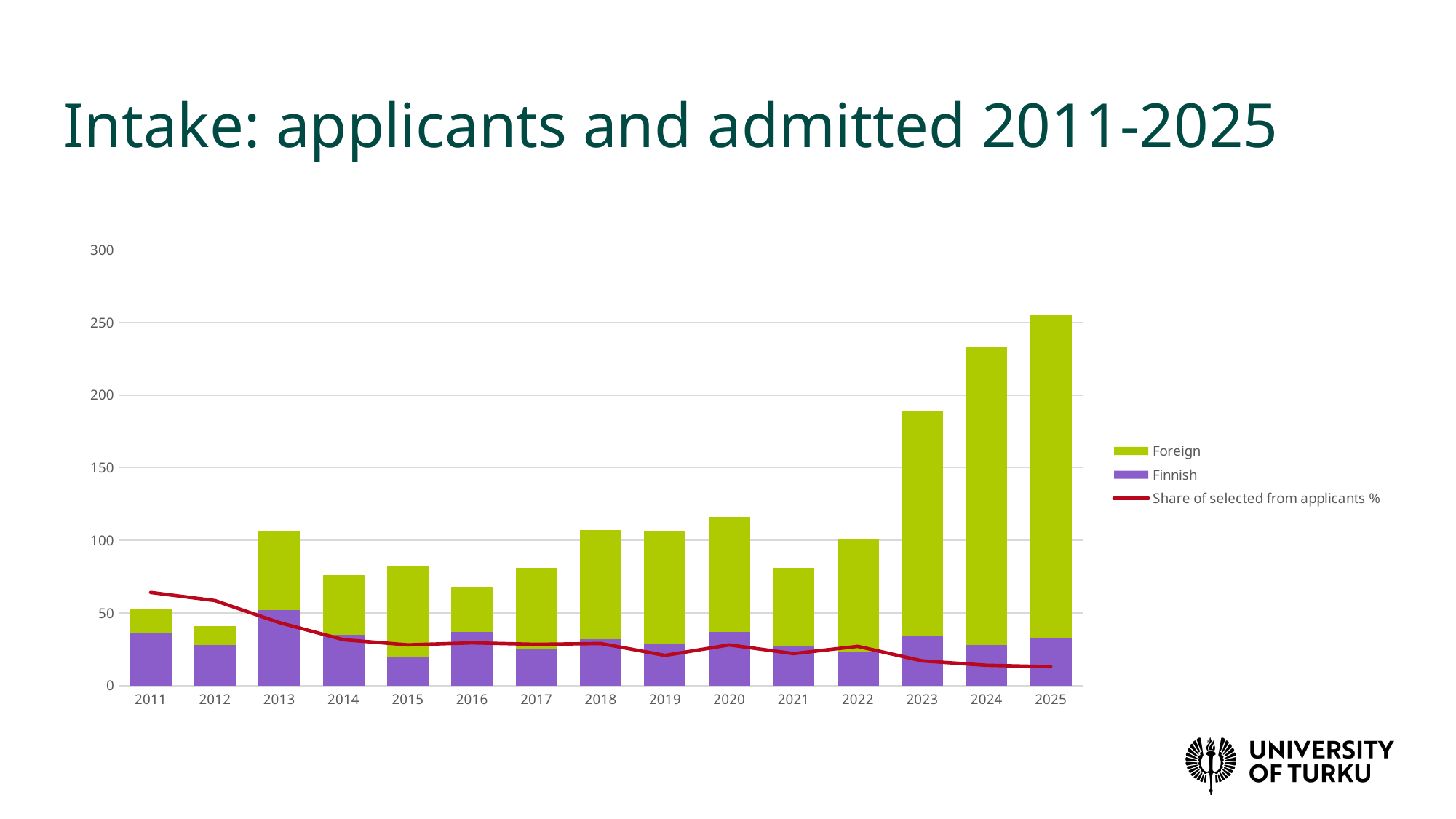
How many years are shown on the x axis? 15 How many series does the legend list? 3 Which series is shown in purple? Finnish Which year has the larger total bar, 2023 or 2024? 2024 Is the total bar height for 2016 greater or less than 100? less Which year has the tallest stacked bar? 2025 Does the 'Share of selected from applicants %' line generally rise or fall from 2011 to 2025? fall Is the Finnish segment for 2015 greater or less than 50? less Is the total bar height for 2020 greater or less than 100? greater Which year has the shortest stacked bar? 2012 What kind of chart is shown on the slide? Stacked bar chart with a line